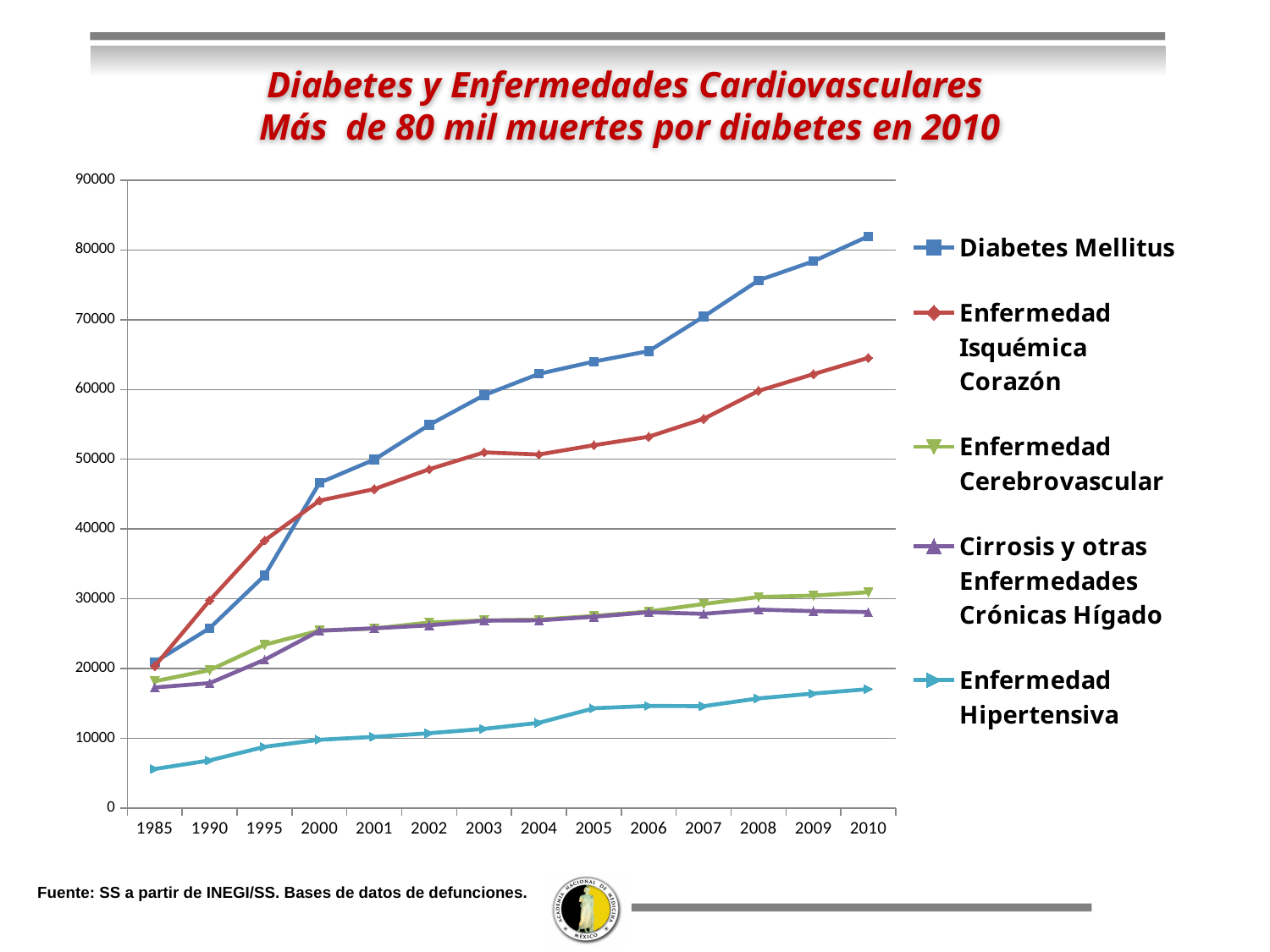
Which series has the lowest value in 2010? Enfermedad Hipertensiva What is the title of the chart? Diabetes y Enfermedades Cardiovasculares Más de 80 mil muertes por diabetes en 2010 Is the value for Enfermedad Isquémica Corazón in 2010 greater or less than 60000? greater Which series has the highest value in 2010? Diabetes Mellitus Is the value for Enfermedad Hipertensiva in 1985 greater or less than 10000? less In 1995, which is larger: Enfermedad Isquémica Corazón or Diabetes Mellitus? Enfermedad Isquémica Corazón How many years are shown along the x axis? 14 Is the value for Enfermedad Cerebrovascular in 2000 greater or less than 30000? less How many series does the legend list? 5 What kind of chart is shown on the slide? line chart Do the values for Diabetes Mellitus rise or fall from 1985 to 2010? rise